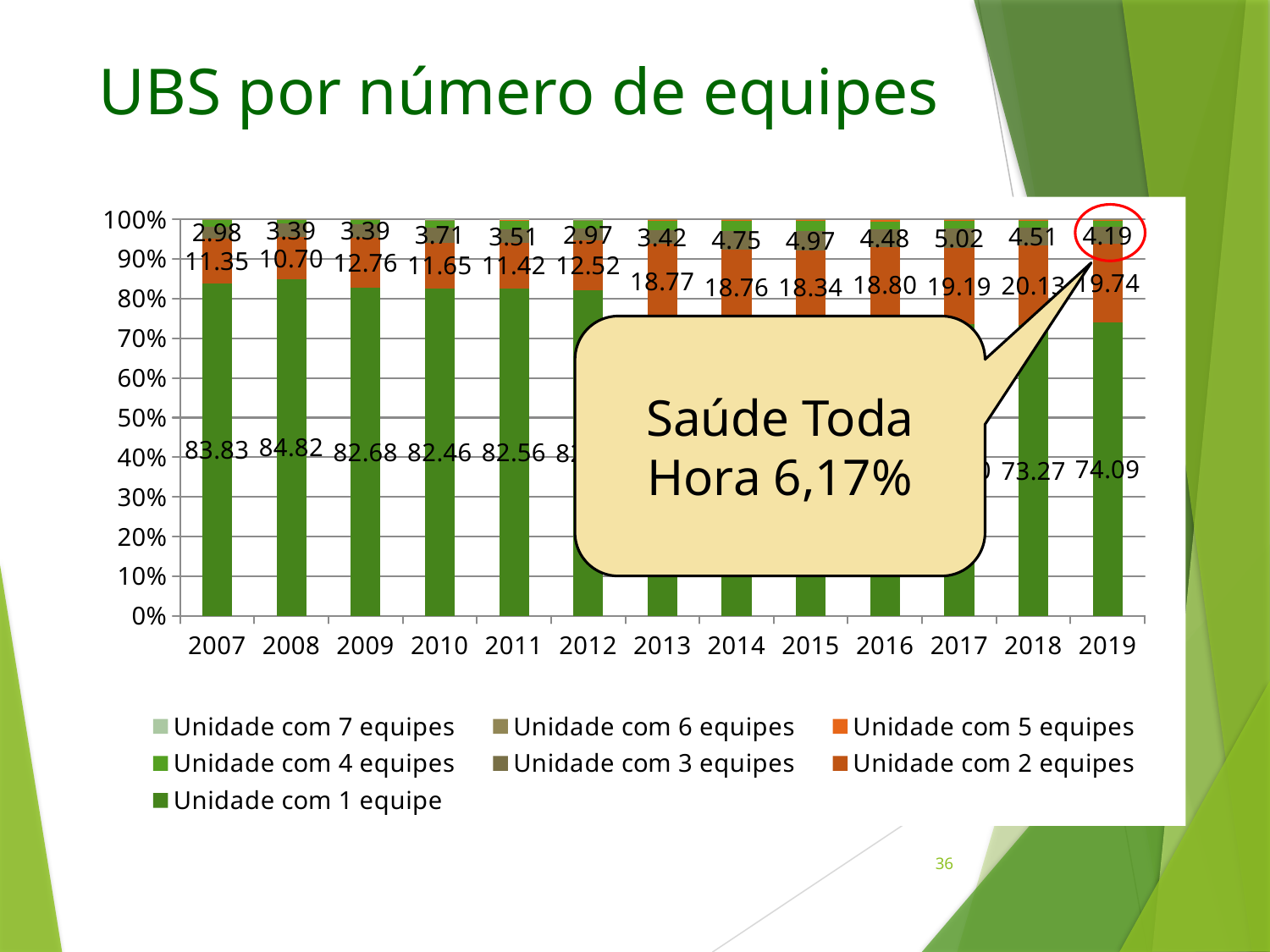
What is the value for 'Unidade com 2 equipes' in 2013? 18.77 In which year is the value for 'Unidade com 2 equipes' highest? 2018 Which is larger, the 'Unidade com 1 equipe' value for 2007 or for 2019? 2007 What is the title of the chart? UBS por número de equipes What is the value for 'Unidade com 2 equipes' in 2019? 19.74 What kind of chart is shown on the slide? Stacked bar chart In which year is the value for 'Unidade com 2 equipes' lowest? 2008 What is the difference between the 'Unidade com 2 equipes' values for 2018 and 2007? 8.78 How many series does the chart legend list? 7 Is the 'Unidade com 1 equipe' value for 2012 greater or less than 70%? greater How many years are shown on the x axis of the chart? 13 What is the value for 'Unidade com 1 equipe' in 2008? 84.82